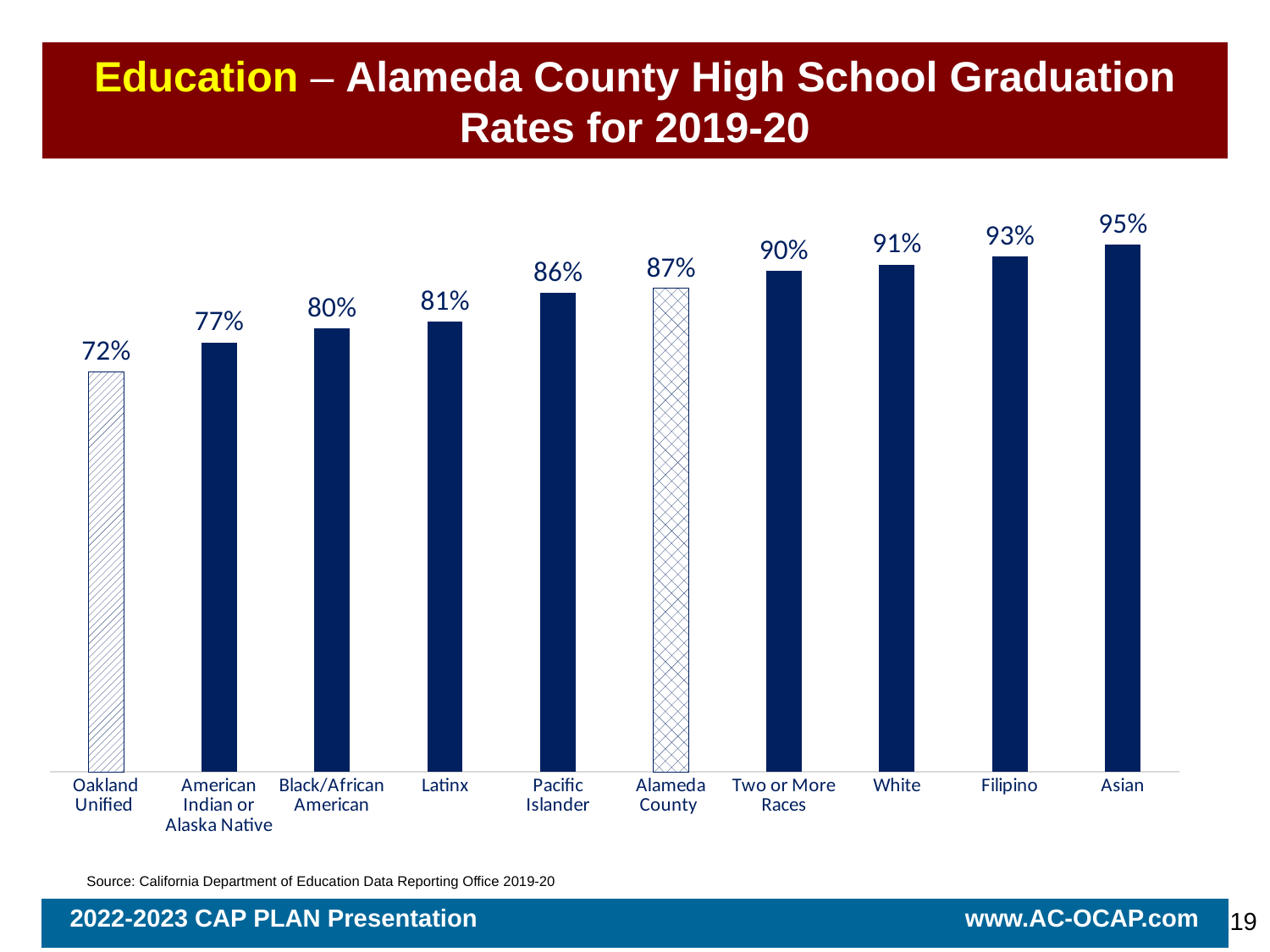
How many categories are shown in the chart? 10 What is the graduation rate for Alameda County? 87% What is the graduation rate for Oakland Unified? 72% Which has a higher graduation rate, Pacific Islander or Black/African American? Pacific Islander Which category has the lowest graduation rate? Oakland Unified What is the difference between the graduation rates for Asian and Oakland Unified? 23% What is the graduation rate for Filipino students? 93% What kind of chart is shown on the slide? Bar chart Do the graduation rates rise or fall from left to right across the chart? Rise Which two bars are drawn with a hatched pattern instead of solid fill? Oakland Unified and Alameda County What is the difference between the graduation rates for White and Latinx? 10% Which category has the highest graduation rate? Asian